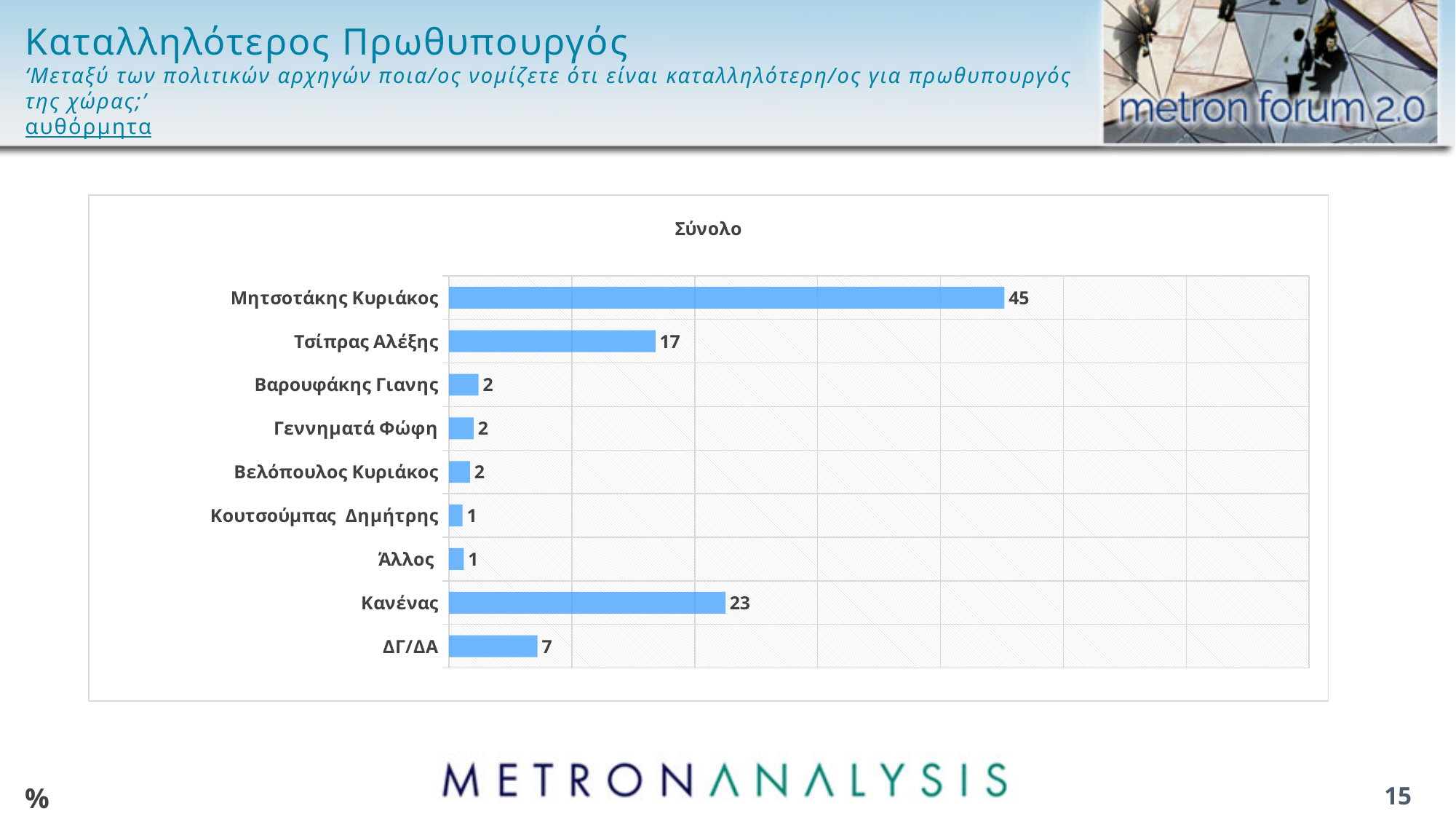
What is the value for Κανένας? 23 What is the value for Μητσοτάκης Κυριάκος? 45 Which is larger, the value for Κανένας or the value for Τσίπρας Αλέξης? Κανένας What is the value for Βελόπουλος Κυριάκος? 2 What kind of chart is shown on the slide? Bar chart What is the title of the chart? Σύνολο What is the difference between the values for Μητσοτάκης Κυριάκος and Τσίπρας Αλέξης? 28 What is the value for Τσίπρας Αλέξης? 17 Which category has the highest value? Μητσοτάκης Κυριάκος What is the difference between the values for Κανένας and Τσίπρας Αλέξης? 6 What is the value for ΔΓ/ΔΑ? 7 How many categories are shown in the chart? 9